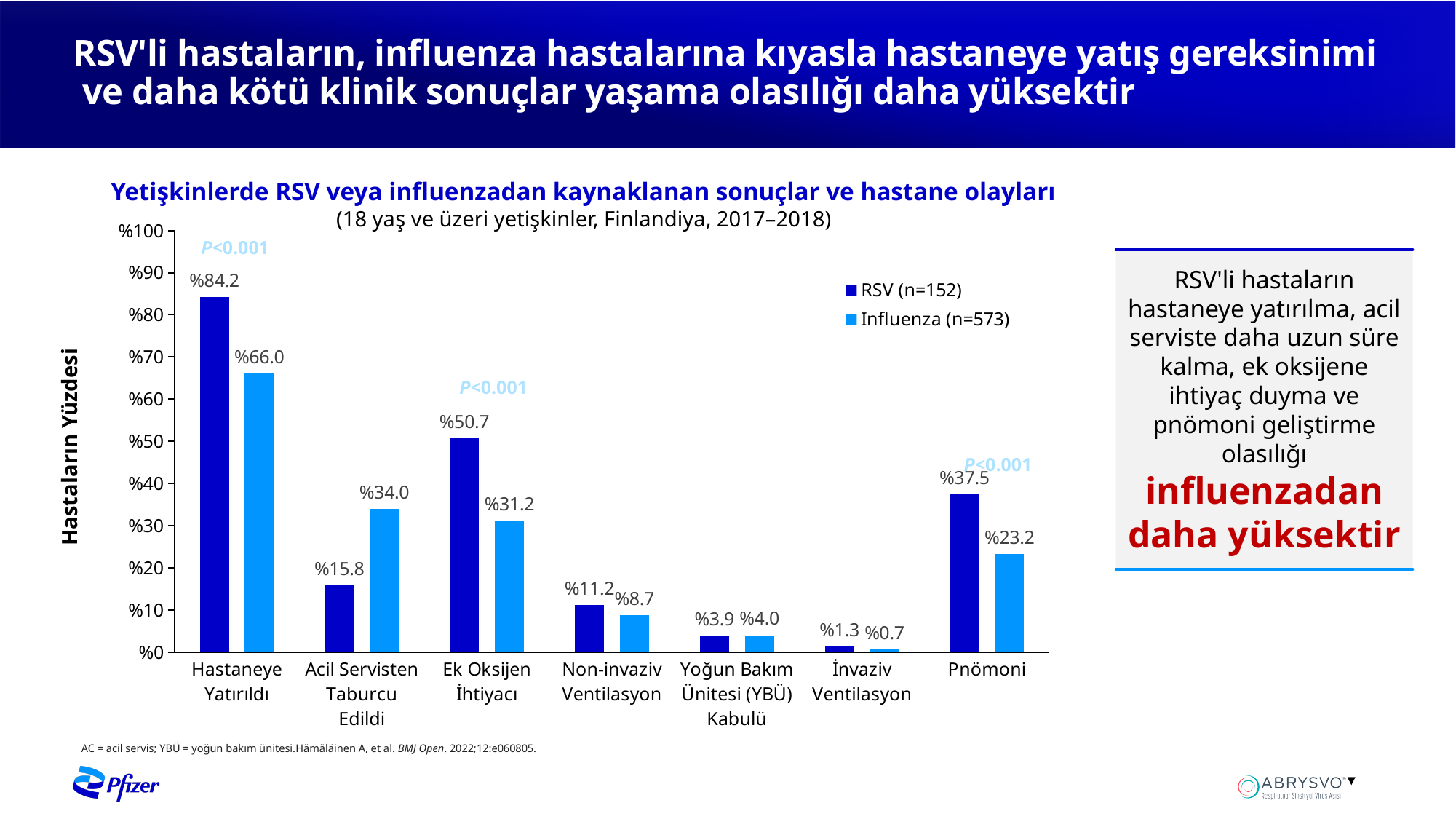
Which category has the highest value for the RSV (n=152) series? Hastaneye Yatırıldı What is the difference between the RSV (n=152) and Influenza (n=573) values in the Ek Oksijen İhtiyacı category? 19.5 percentage points What kind of chart is shown on the slide? Bar chart Is the value for RSV (n=152) in the Pnömoni category greater or less than %30? greater Which category has the lowest value for the Influenza (n=573) series? İnvaziv Ventilasyon Which series has the larger value in the Acil Servisten Taburcu Edildi category, RSV (n=152) or Influenza (n=573)? Influenza (n=573) How many categories are shown on the x axis of the chart? 7 What is the label of the y axis of the chart? Hastaların Yüzdesi What is the value for Influenza (n=573) in the Acil Servisten Taburcu Edildi category? %34.0 What is the value for Influenza (n=573) in the Pnömoni category? %23.2 How many series does the chart legend list? 2 What is the value for RSV (n=152) in the Hastaneye Yatırıldı category? %84.2